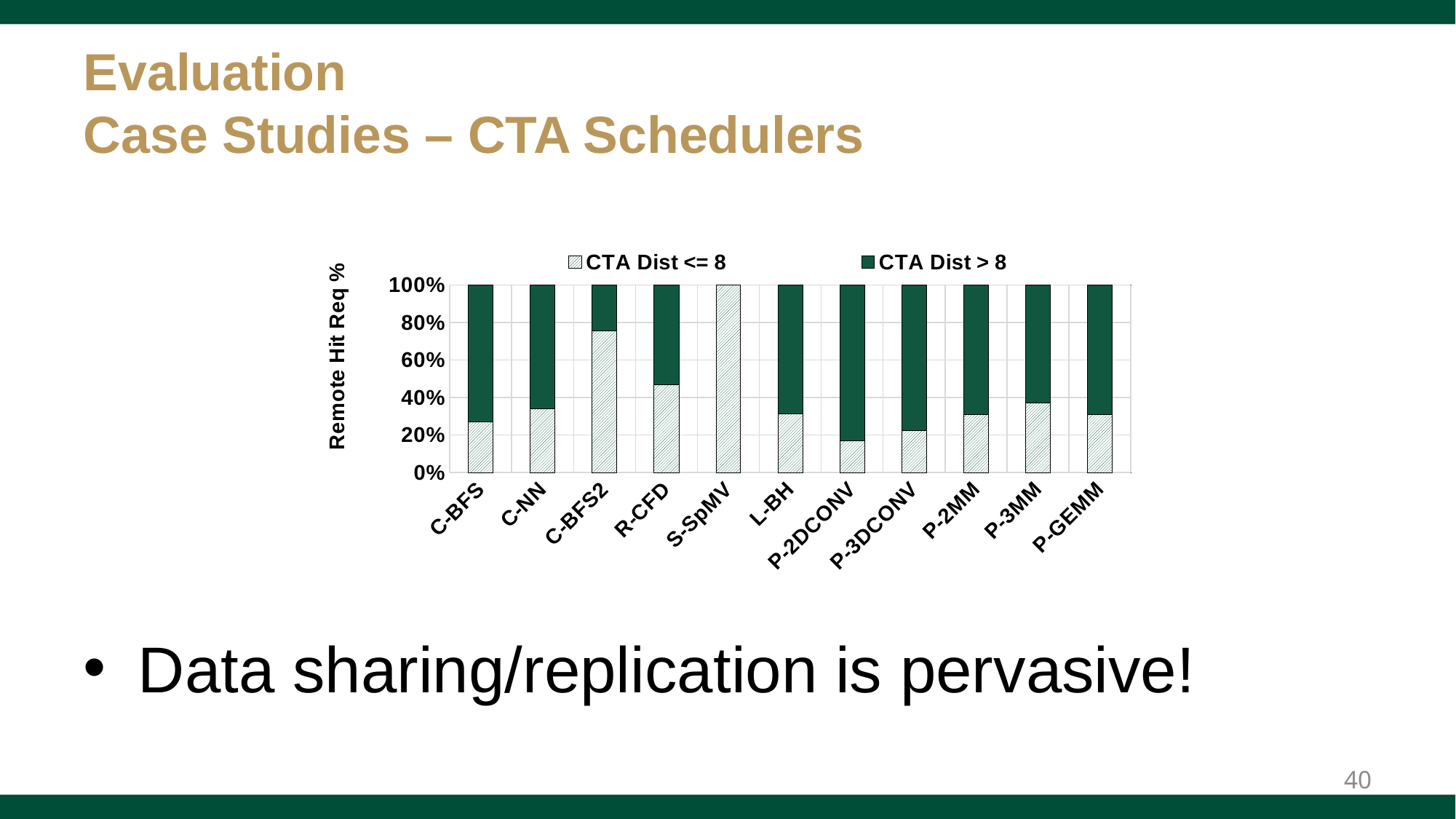
How many series does the legend list? 2 Is the CTA Dist <= 8 value for R-CFD greater or less than 60%? less What is the label of the y axis? Remote Hit Req % Is the CTA Dist <= 8 value for P-2DCONV greater or less than 20%? less Is the CTA Dist <= 8 value for C-BFS2 greater or less than 60%? greater Which benchmark has the lowest CTA Dist <= 8 share? P-2DCONV How many benchmark categories are shown on the x axis? 11 Which benchmark has the highest CTA Dist <= 8 share? S-SpMV What kind of chart is shown on the slide? stacked bar chart Which has a larger CTA Dist <= 8 share, C-BFS2 or R-CFD? C-BFS2 What is the total height of the stacked bar for C-NN? 100% What is the CTA Dist <= 8 value for S-SpMV? 100%